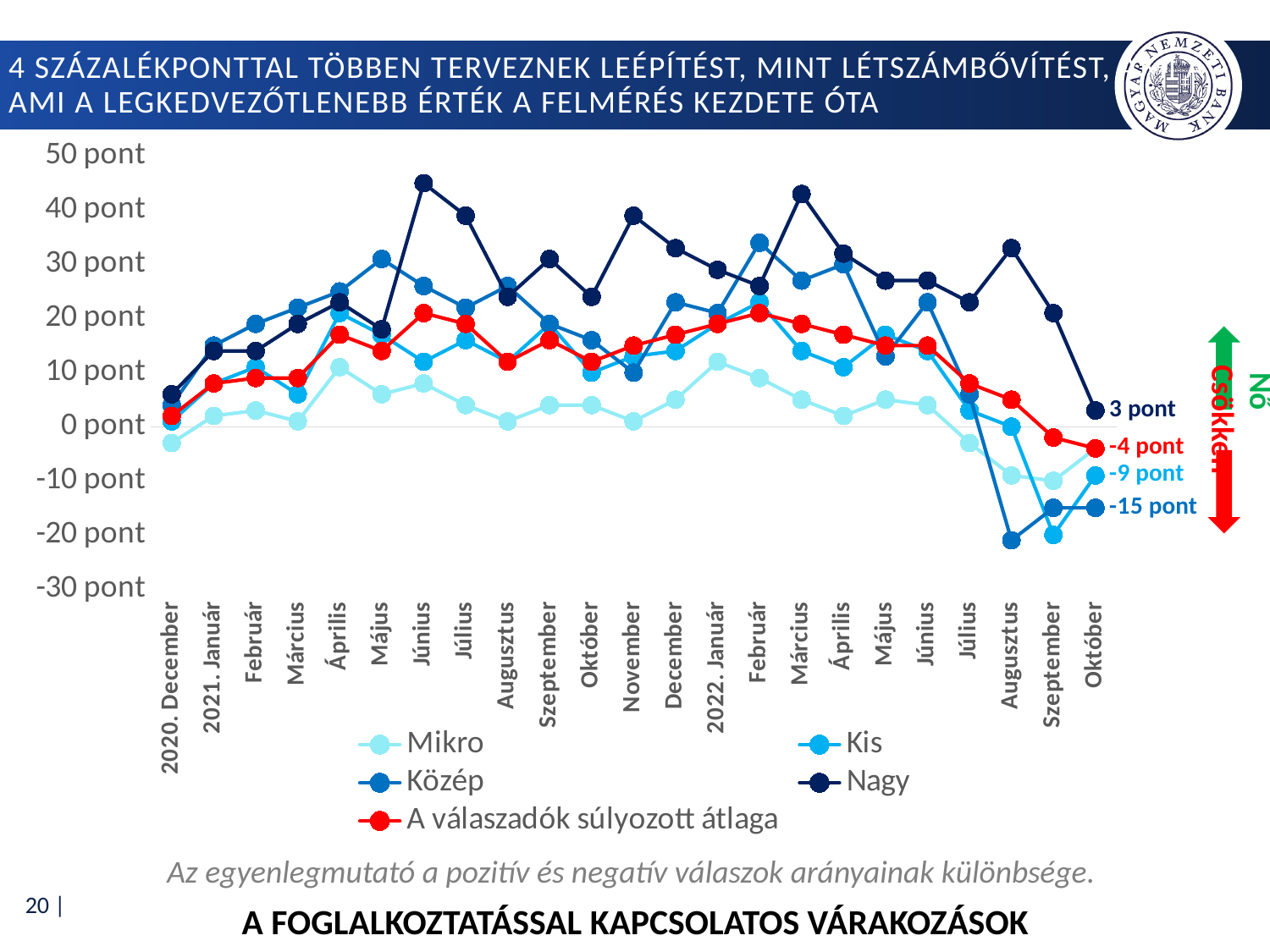
What is the value of 'A válaszadók súlyozott átlaga' at the last point (Október 2022)? -4 pont How many series does the legend list? 5 What is the value of the Közép series at the last point (Október 2022)? -15 pont At the last point (Október 2022), which is larger: the Nagy value or the Közép value? Nagy What kind of chart is shown on the slide? line chart Which series has the highest value at the last point (Október 2022)? Nagy Is the value of the Nagy series at Június 2021 greater or less than 40 pont? greater At the last point (Október 2022), what is the difference between the Nagy value and the Közép value? 18 pont Does the Nagy series rise or fall from Augusztus 2022 to Október 2022? fall What is the value of the Nagy series at Október (2022), the last point on the chart? 3 pont How many months (categories) are shown on the x axis? 23 What is the value of the Kis series at the last point (Október 2022)? -9 pont